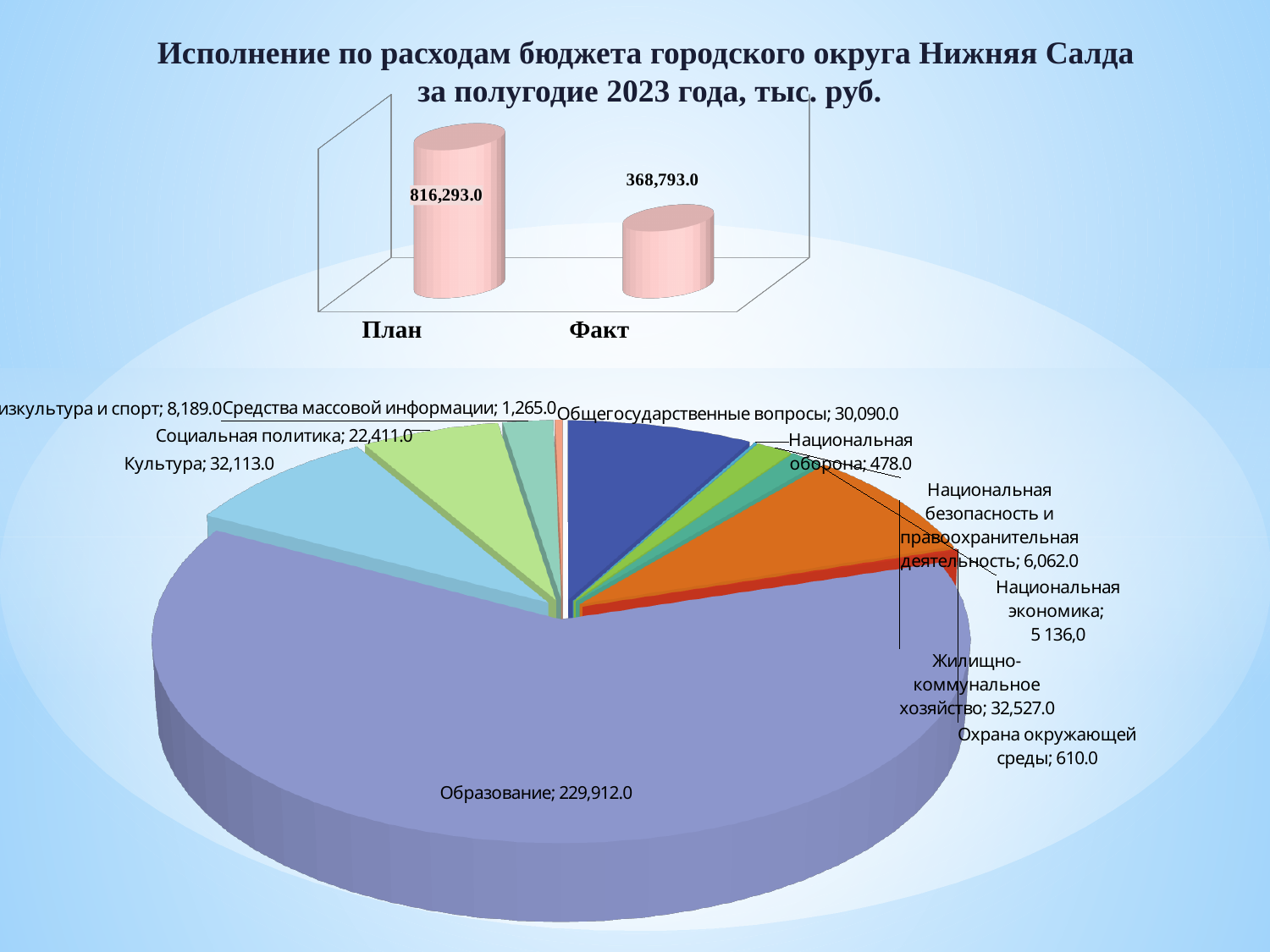
In the bottom pie chart, what is the value for Жилищно-коммунальное хозяйство? 32,527.0 In the top bar chart, which is larger, План or Факт? План In the top bar chart, what is the difference between План and Факт? 447,500.0 In the bottom pie chart, what is the value for Образование? 229,912.0 In the top bar chart, what is the value for Факт? 368,793.0 In the top bar chart, what is the value for План? 816,293.0 In the bottom pie chart, what is the value for Национальная оборона? 478.0 What kind of chart is the bottom chart on the slide? Pie chart In the bottom pie chart, which is larger, Культура or Социальная политика? Культура How many slices does the bottom pie chart have? 11 In the bottom pie chart, which category has the smallest value? Национальная оборона In the bottom pie chart, which category has the largest value? Образование